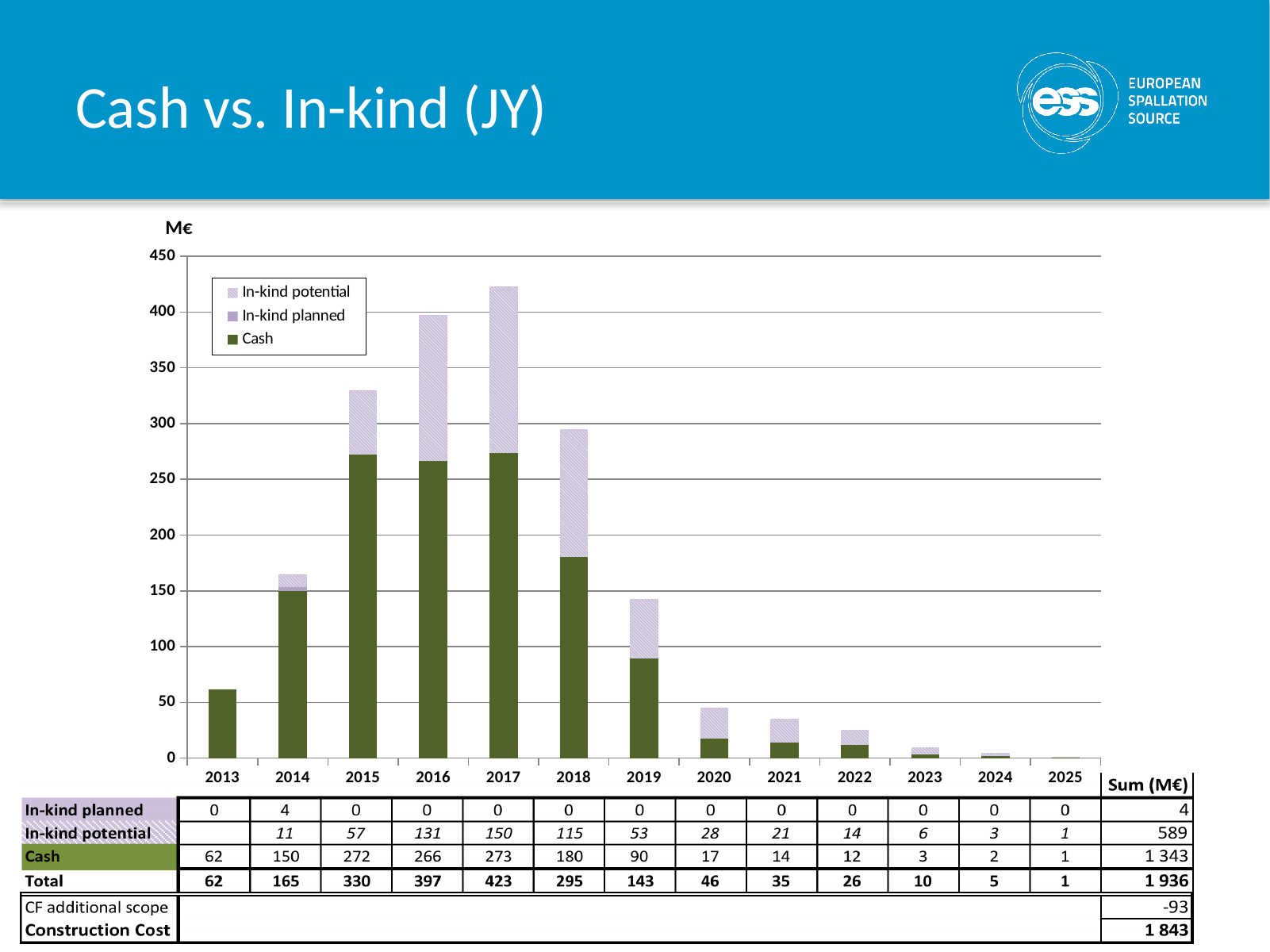
How many series does the legend list? 3 Which year has the highest total? 2017 What is the difference between the Cash values for 2015 and 2016? 6 Which is larger, the Cash value for 2019 or the Cash value for 2020? 2019 What is the In-kind planned value for 2014? 4 What is the total of the stacked bar for 2018? 295 What kind of chart is shown on the slide? stacked bar chart Do the totals rise or fall from 2017 to 2025? fall How many years are shown on the x axis of the chart? 13 What is the In-kind potential value for 2016? 131 What is the Cash value for 2017? 273 Which year has the lowest total? 2025